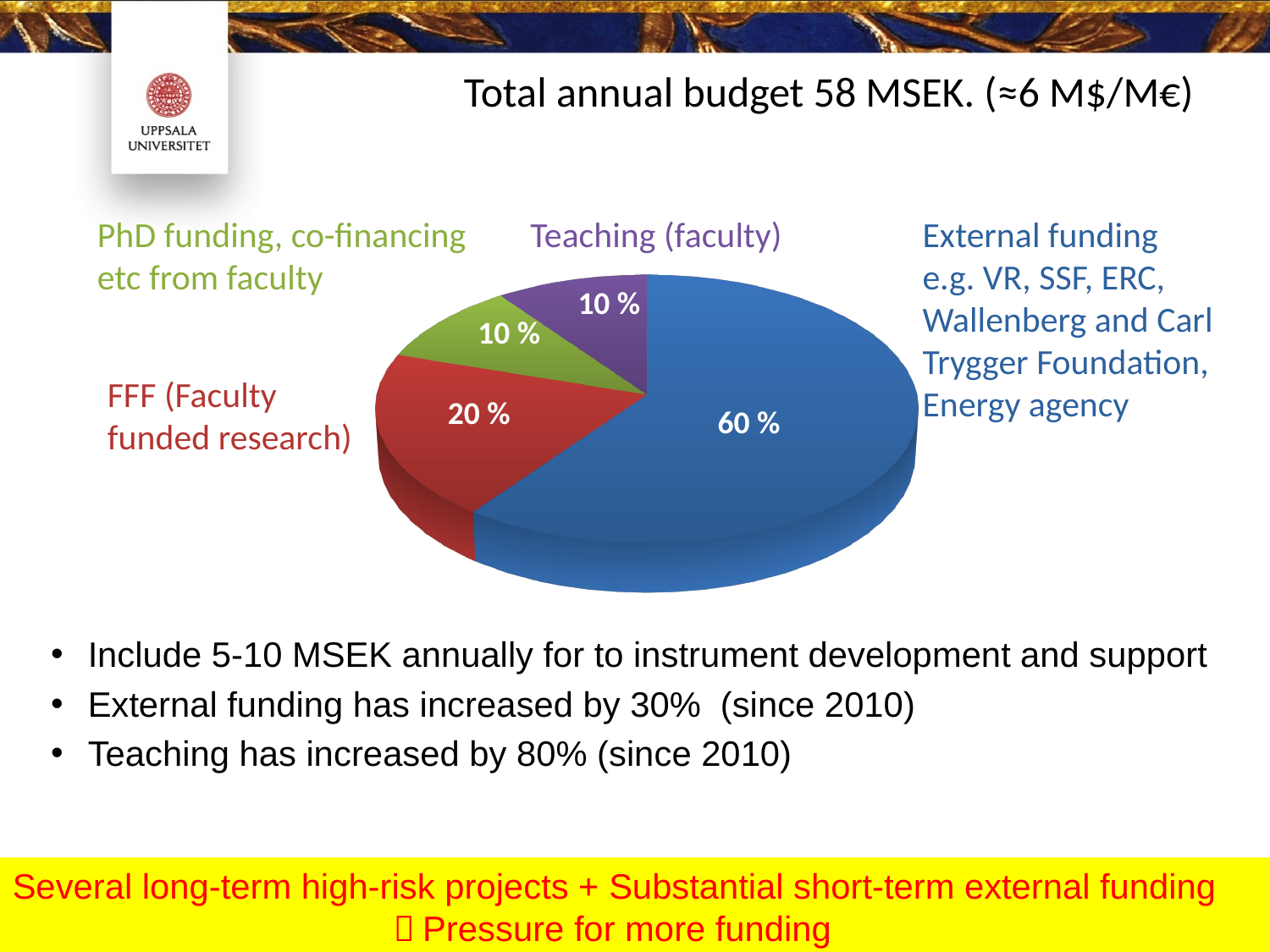
What share of the budget is FFF (Faculty funded research)? 20 % What is the difference in percentage points between External funding and FFF (Faculty funded research)? 40 Which category has the largest slice of the pie? External funding What kind of chart is shown on the slide? pie chart What total annual budget is stated in the slide title? 58 MSEK What is the combined share of the two 10 % slices, PhD funding and Teaching (faculty)? 20 % Which is larger, the FFF (Faculty funded research) slice or the Teaching (faculty) slice? FFF (Faculty funded research) What share of the budget does External funding account for? 60 % What colour is the External funding slice? blue What share of the budget is Teaching (faculty)? 10 % How many slices does the pie chart have? 4 What share of the budget is PhD funding, co-financing etc from faculty? 10 %